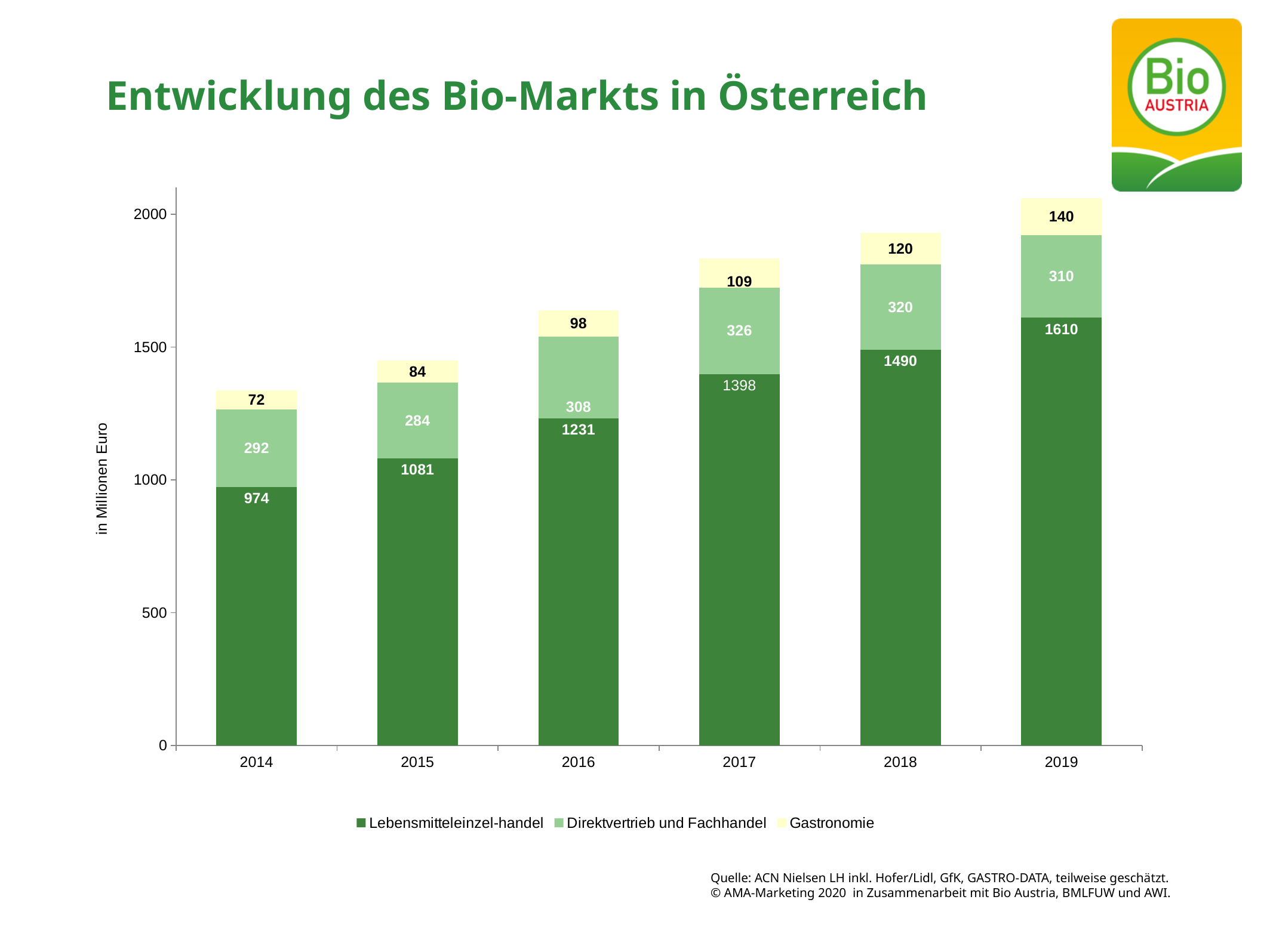
What is the value for Direktvertrieb und Fachhandel in 2017? 326 In which year is the Lebensmitteleinzel-handel value highest? 2019 What is the value for Gastronomie in 2014? 72 How many years are shown on the x axis? 6 In which year is the Gastronomie value lowest? 2014 What is the total of the stacked bar for 2019? 2060 What kind of chart is shown on the slide? Stacked bar chart What is the total of the stacked bar for 2014? 1338 How many series does the legend list? 3 What is the difference between the Lebensmitteleinzel-handel values for 2019 and 2018? 120 What is the value for Lebensmitteleinzel-handel in 2019? 1610 Which is larger: Direktvertrieb und Fachhandel in 2018 or in 2019? 2018